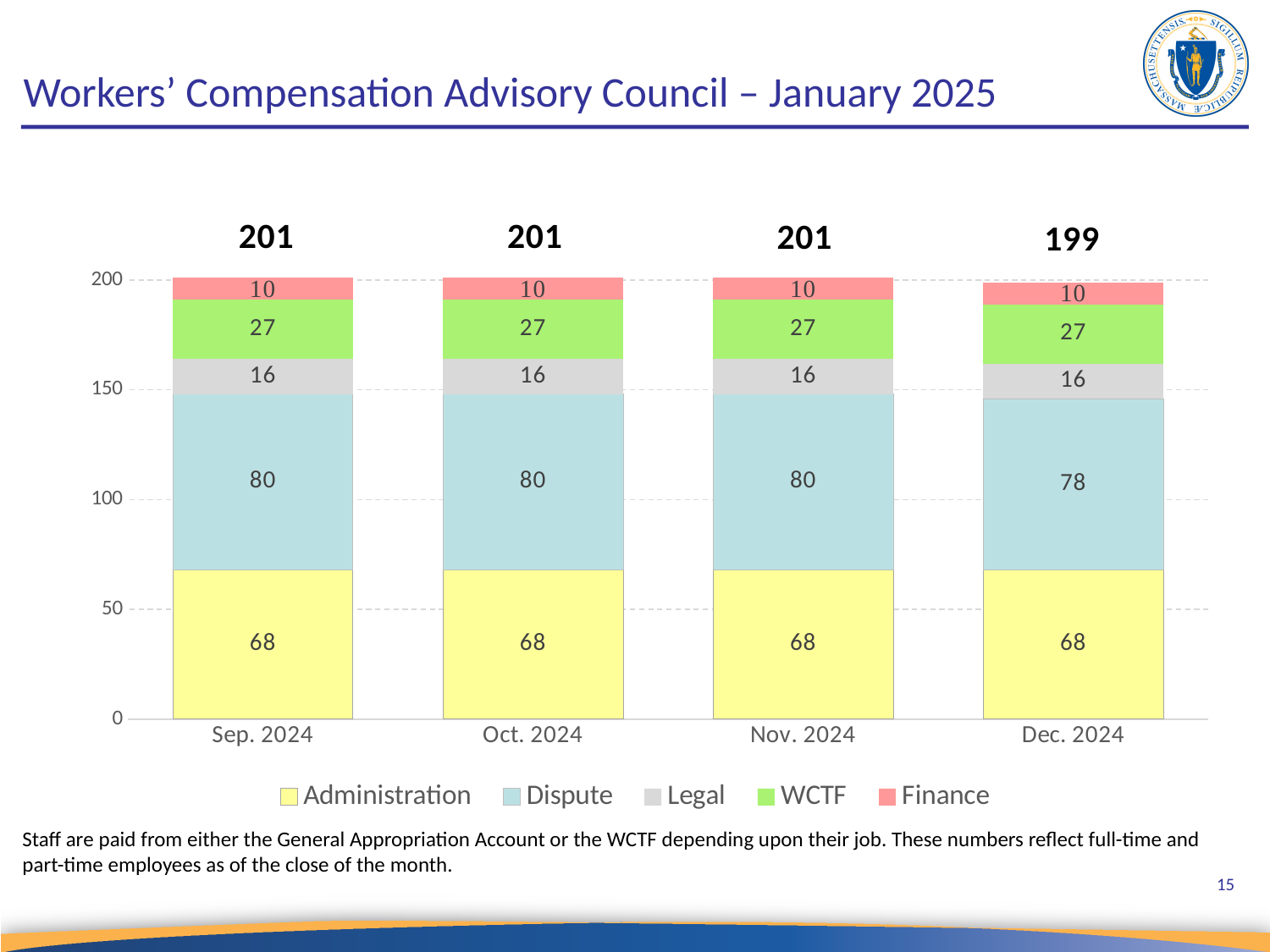
Which month has the lowest total? Dec. 2024 What kind of chart is shown on the slide? Stacked bar chart What is the difference between the Dispute values for Nov. 2024 and Dec. 2024? 2 What is the WCTF value for Nov. 2024? 27 How many series does the legend list? 5 What is the total of the stacked bar for Sep. 2024? 201 How many months are shown on the x axis? 4 What is the total of the stacked bar for Dec. 2024? 199 What is the Dispute value for Dec. 2024? 78 What is the Finance value for Oct. 2024? 10 What is the Administration value for Sep. 2024? 68 Which is larger in Oct. 2024, the Dispute value or the Administration value? Dispute